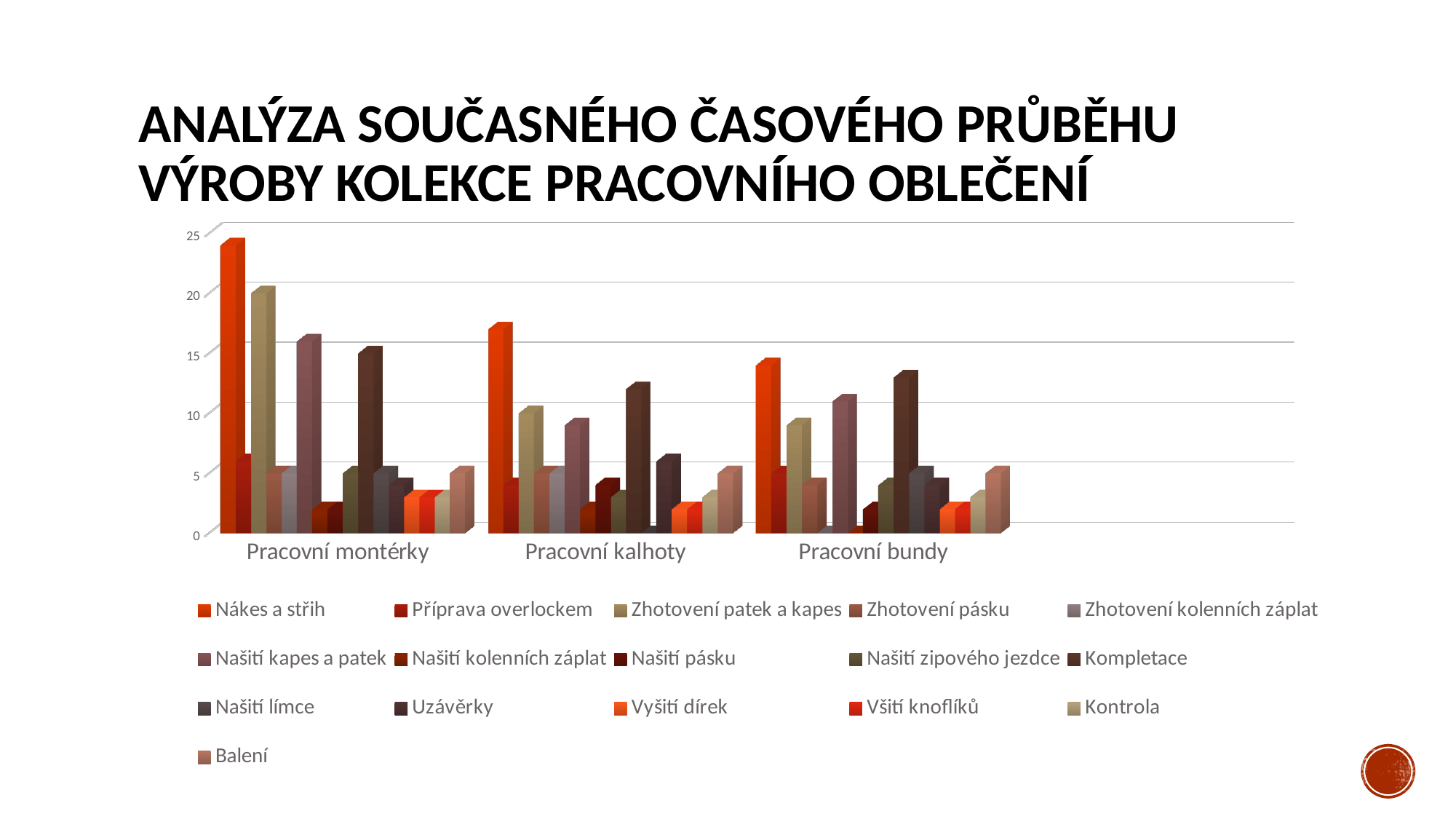
Is the value for Kompletace in Pracovní bundy greater or less than 10? greater What is the name of the last series listed in the chart legend? Balení Is the value for Nákes a střih in Pracovní montérky greater or less than 20? greater How many series does the chart legend list? 16 Which category has the highest value for Nákes a střih? Pracovní montérky Is the value for Nákes a střih in Pracovní kalhoty greater or less than 15? greater How many categories are shown on the x axis of the chart? 3 What kind of chart is shown on the slide? bar chart Do the values for Nákes a střih rise or fall from Pracovní montérky to Pracovní bundy? fall Which is larger: Nákes a střih for Pracovní montérky or Nákes a střih for Pracovní kalhoty? Pracovní montérky